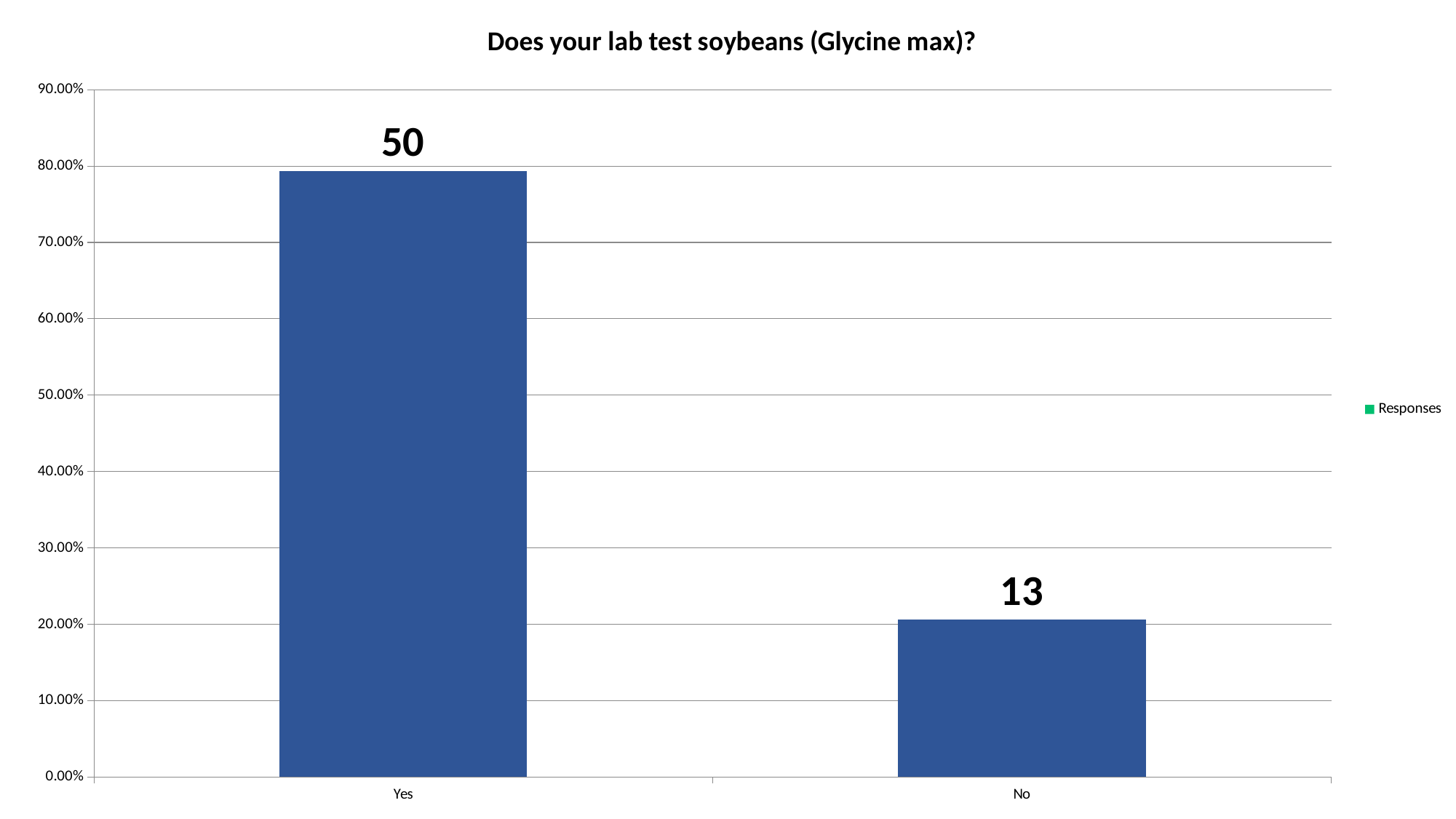
Is the value for Yes greater or less than 70.00%? greater What is the data label shown on the No bar? 13 Which category has the lowest bar? No Is the value for No greater or less than 30.00%? less What is the difference between the data labels for Yes and No? 37 Which bar is taller, Yes or No? Yes How many series does the legend list? 1 Which category has the highest bar? Yes How many categories are shown on the x axis? 2 What is the title of the chart? Does your lab test soybeans (Glycine max)? What is the data label shown on the Yes bar? 50 What kind of chart is shown on the slide? bar chart